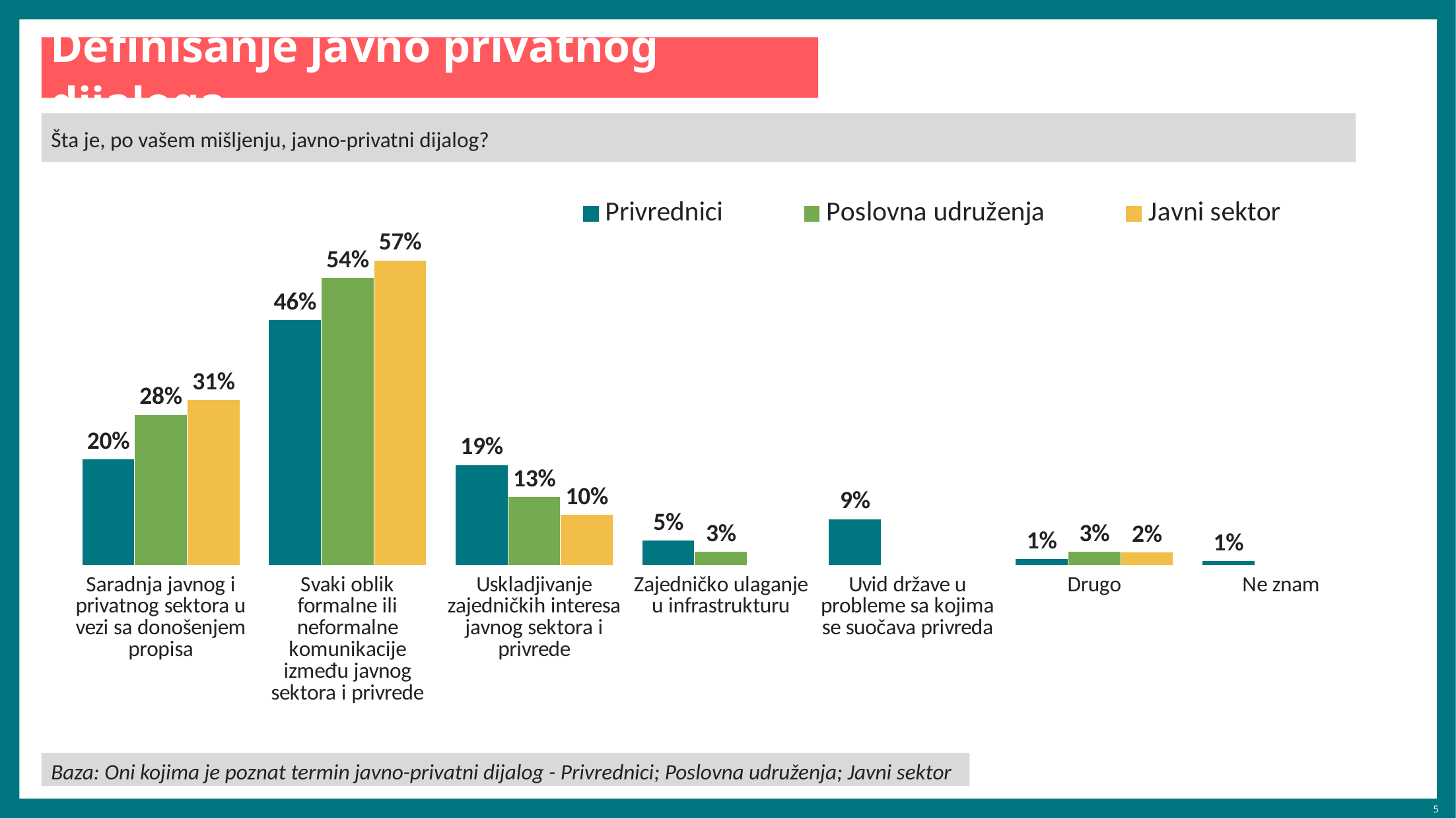
What is the value for Javni sektor in the category 'Svaki oblik formalne ili neformalne komunikacije između javnog sektora i privrede'? 57% What is the value for Poslovna udruženja in the category 'Uskladjivanje zajedničkih interesa javnog sektora i privrede'? 13% What is the difference between the Javni sektor and Privrednici values in the category 'Svaki oblik formalne ili neformalne komunikacije između javnog sektora i privrede'? 11% In the category 'Uskladjivanje zajedničkih interesa javnog sektora i privrede', which series has the larger value, Privrednici or Javni sektor? Privrednici How many series does the legend list? 3 How many categories are shown on the x axis of the chart? 7 Which category has the highest value for Privrednici? Svaki oblik formalne ili neformalne komunikacije između javnog sektora i privrede What kind of chart is shown on the slide? bar chart What is the value for Privrednici in the category 'Uvid države u probleme sa kojima se suočava privreda'? 9% What is the value for Privrednici in the category 'Saradnja javnog i privatnog sektora u vezi sa donošenjem propisa'? 20% Which series is shown in yellow in the legend? Javni sektor